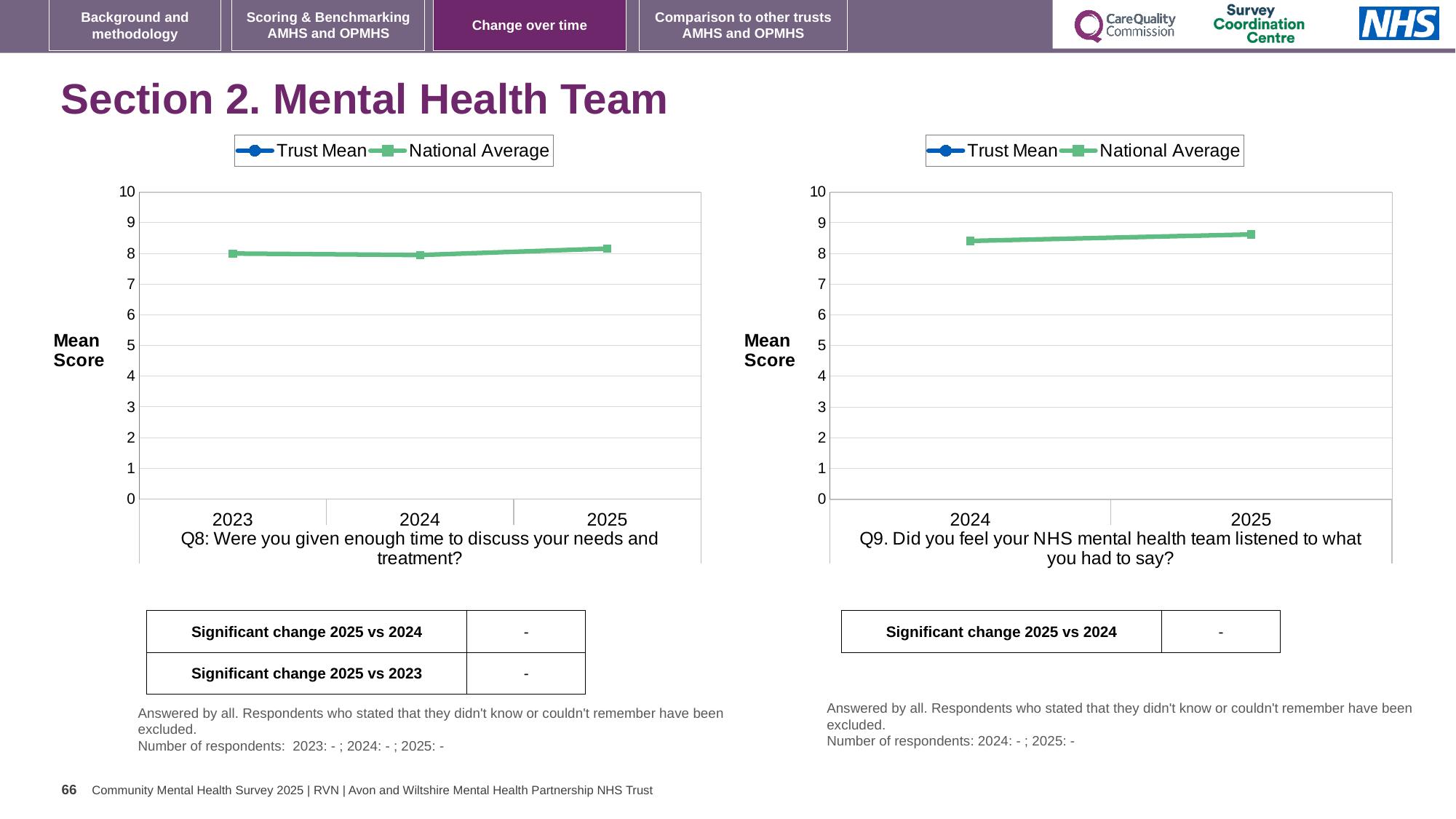
How many years are shown on the x axis of the Q9 chart? 2 What kind of chart is the Q9 chart on the right? line chart How many years are shown on the x axis of the Q8 chart? 3 What kind of chart is the Q8 chart on the left? line chart In the Q9 chart, does the National Average line rise or fall from 2024 to 2025? rise What are the two series named in the legend of the Q9 chart? Trust Mean and National Average How many series does the legend of the Q8 chart list? 2 In the Q8 chart, is the National Average value for 2025 greater or less than 7? greater What is the y-axis label on the Q8 chart? Mean Score In the Q9 chart, is the National Average value for 2025 greater or less than 8? greater In the Q8 chart, is the National Average value for 2023 greater or less than 9? less